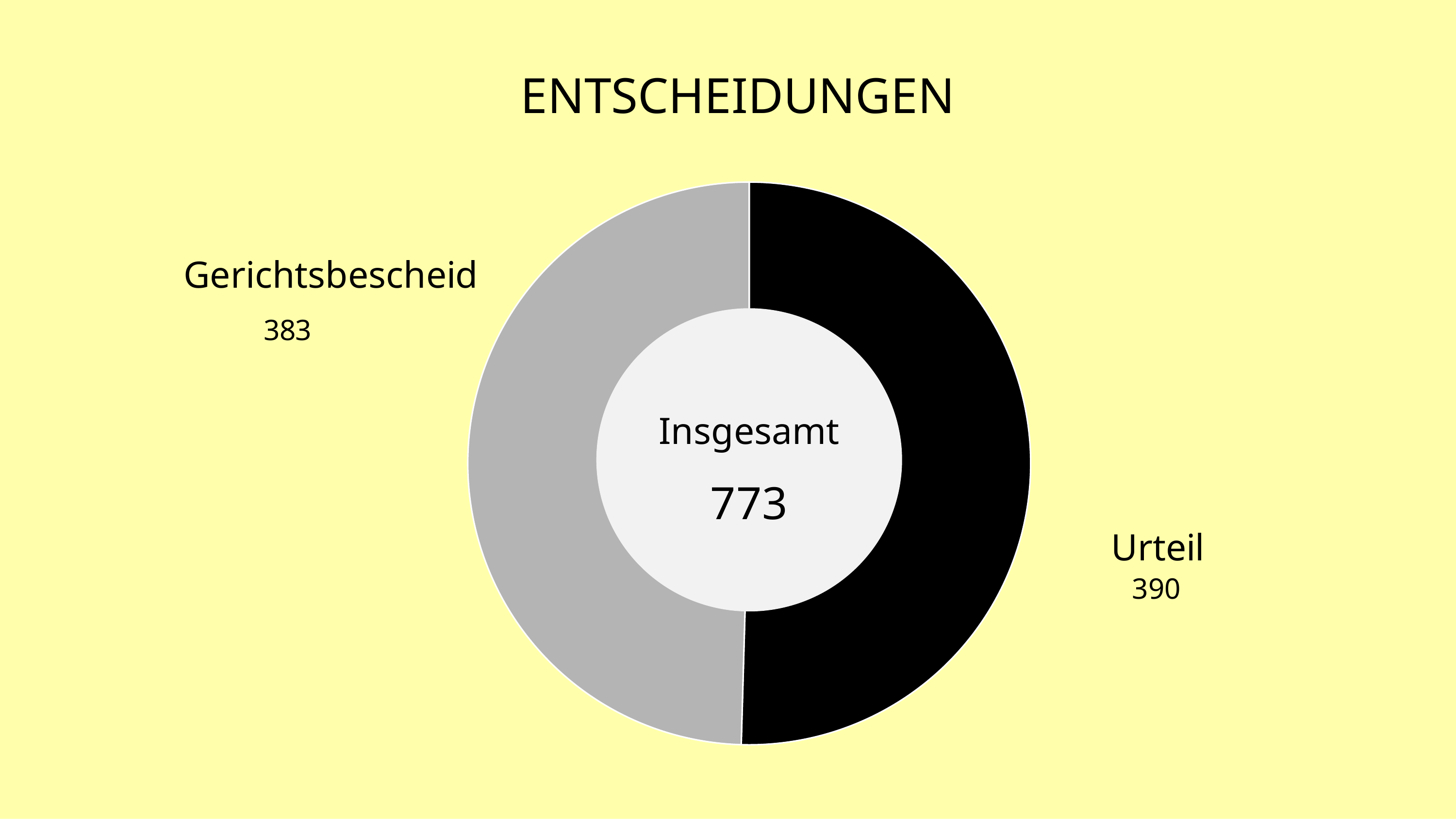
What is the value for Urteil? 390 Which category has the higher value, Gerichtsbescheid or Urteil? Urteil What type of chart is shown on the slide? Doughnut chart Which category has the lowest value? Gerichtsbescheid What is the value for Gerichtsbescheid? 383 What is the difference between the values for Urteil and Gerichtsbescheid? 7 Which category has the highest value? Urteil What total is shown in the centre of the doughnut chart? 773 What label appears in the centre of the doughnut chart above the total? Insgesamt How many categories are shown in the doughnut chart? 2 What is the title of the chart? ENTSCHEIDUNGEN What is the sum of the values for Gerichtsbescheid and Urteil? 773